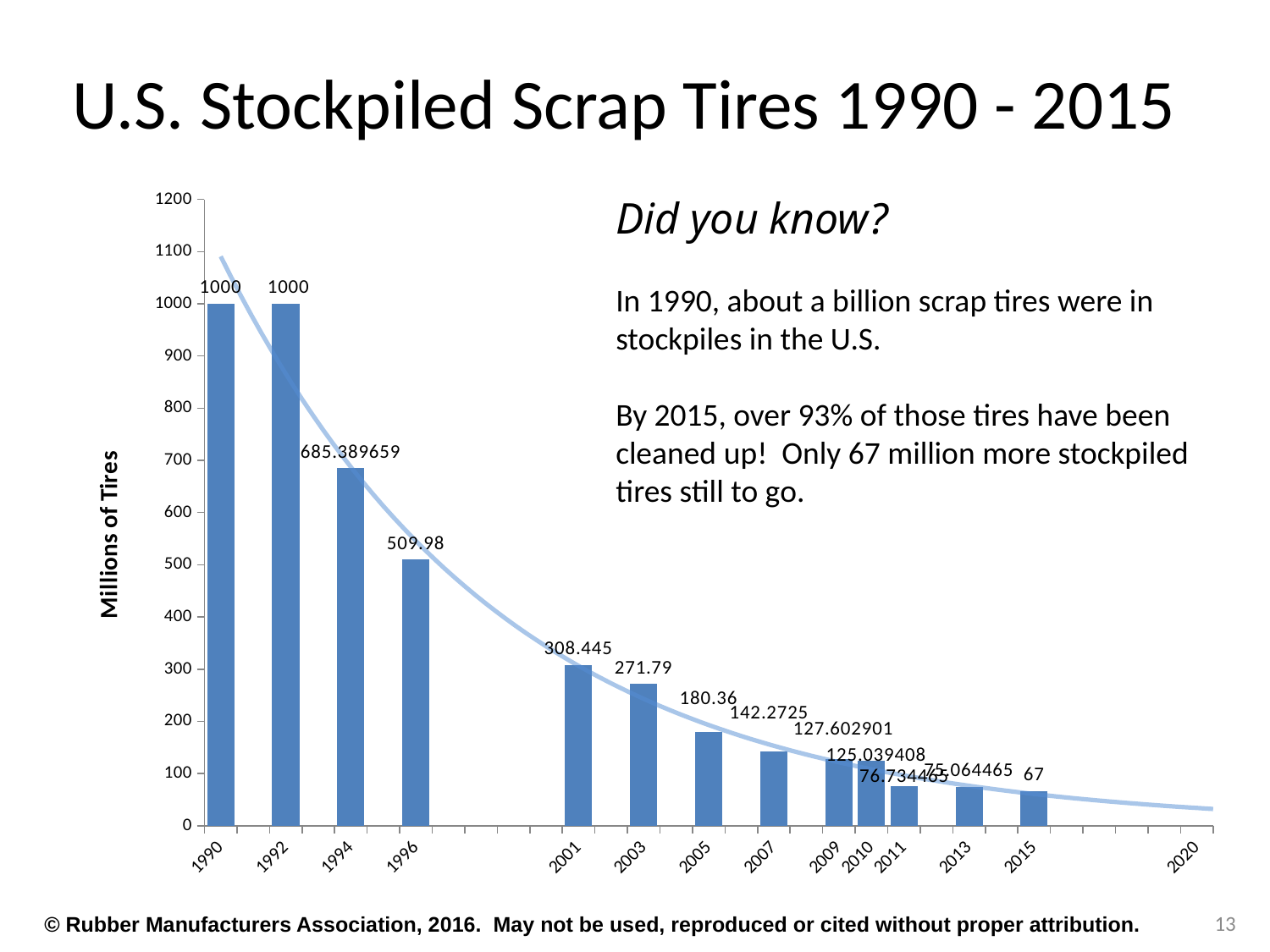
What is the value for 1994? 685.389659 Which year has the lowest value? 2015 Is the value for 2011 greater or less than 100? less How many bars are plotted in the chart? 13 What is the difference between the values for 2003 and 2005? 91.43 Do the values generally rise or fall from 1990 to 2015? fall What is the difference between the values for 1990 and 2015? 933 What is the value for 1996? 509.98 What kind of chart is shown? bar chart What is the value for 2001? 308.445 Which is larger, the value for 2007 or the value for 2009? 2007 What is the value for 2015? 67